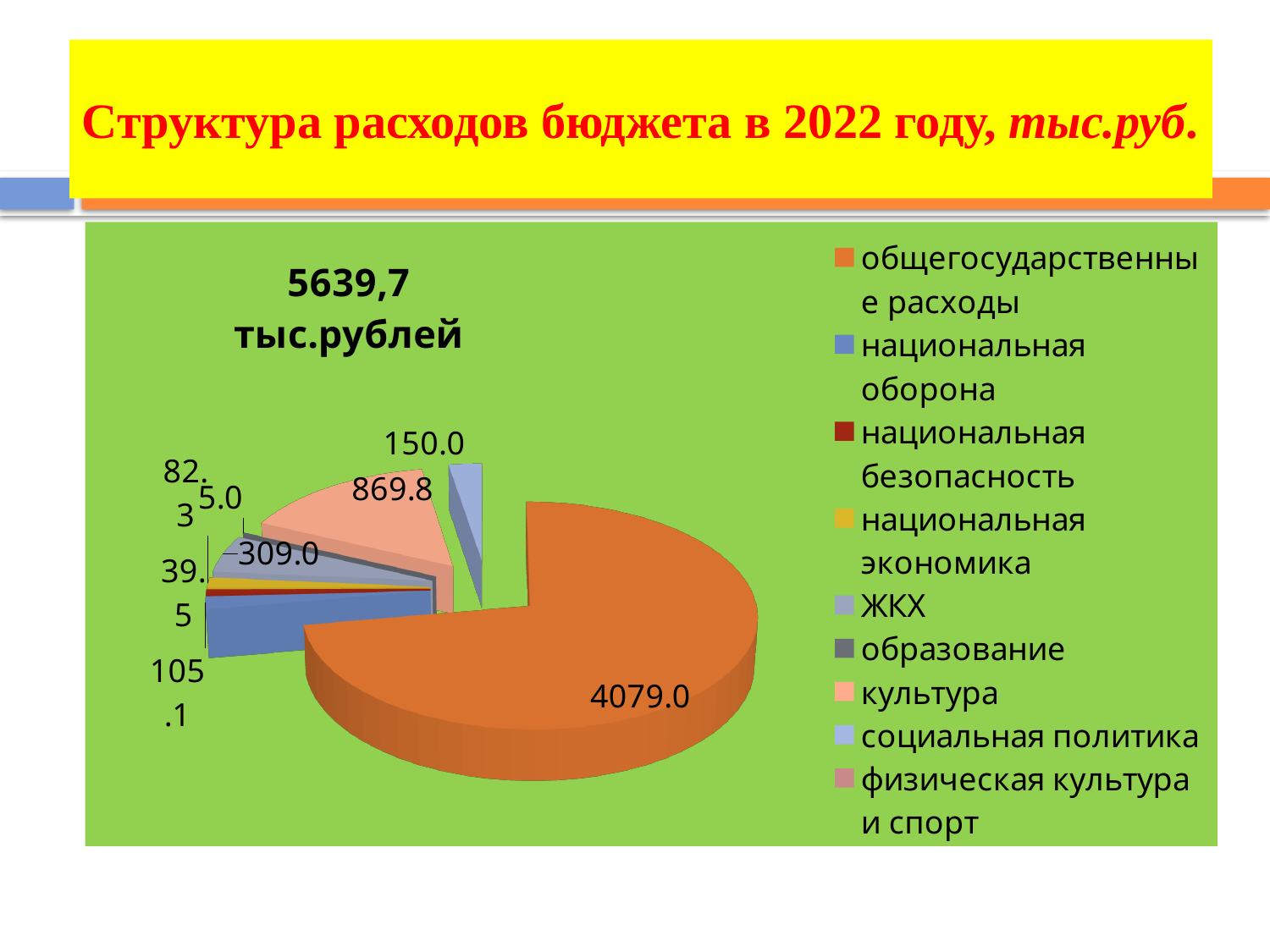
What is the value for ЖКХ? 309.0 How many entries does the legend list? 9 What is the difference between культура and социальная политика? 719.8 What kind of chart is shown on the slide? pie chart What is the value for социальная политика? 150.0 Which category has the largest slice of the pie? общегосударственные расходы What is the value for национальная оборона? 105.1 What is the title shown above the pie chart? 5639,7 тыс.рублей Which is larger, культура or ЖКХ? культура What is the value for культура? 869.8 What is the value for общегосударственные расходы? 4079.0 What is the smallest value printed on the pie chart? 5.0